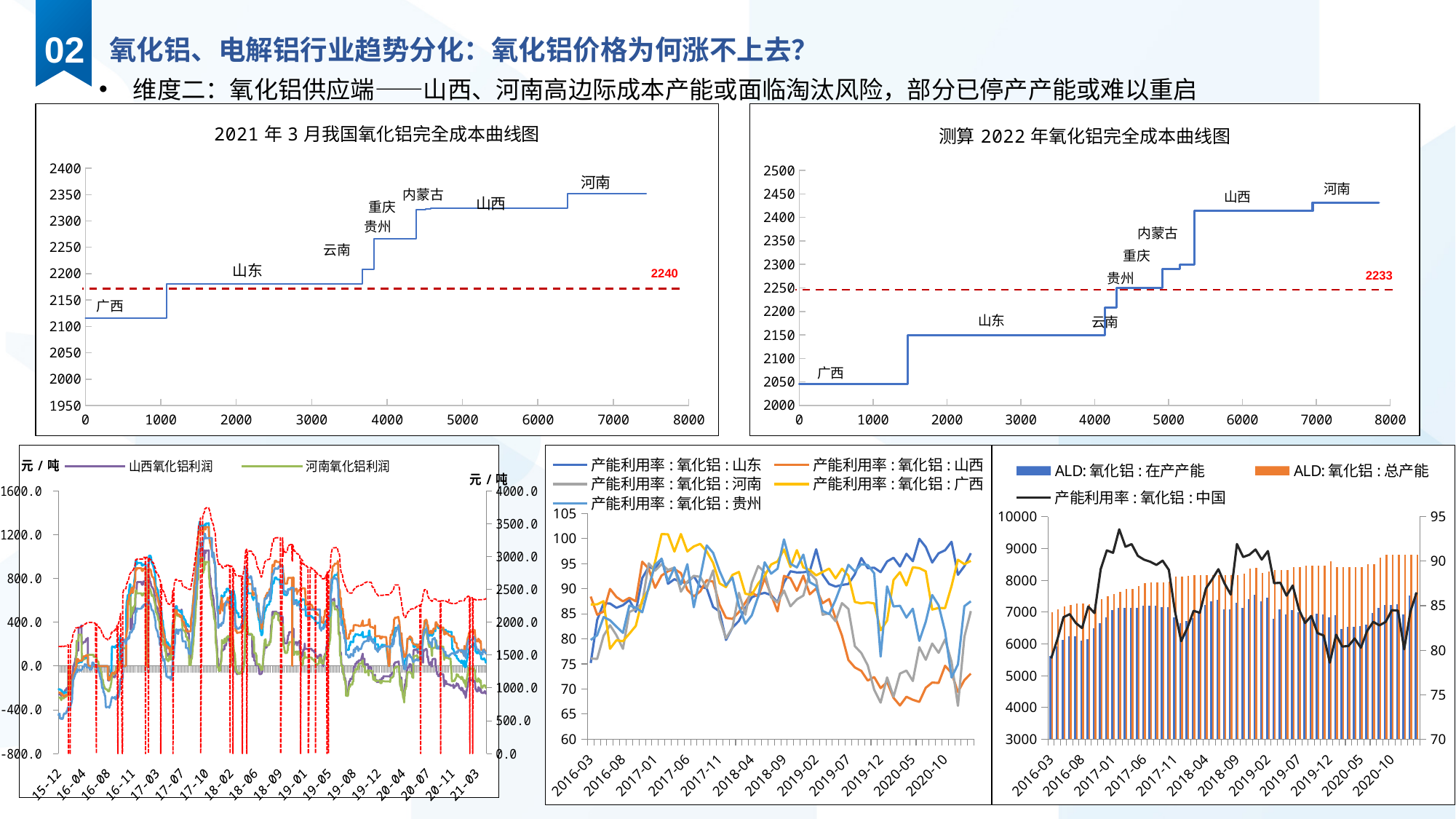
On the bottom-left chart, how many series does the legend list? 2 On the chart titled 测算2022年氧化铝完全成本曲线图, is the cost level for 山东 greater or less than 2200? less On the chart titled 测算2022年氧化铝完全成本曲线图, what value is printed on the red dashed horizontal line? 2233 On the chart titled 2021年3月我国氧化铝完全成本曲线图, is the cost level for 广西 greater or less than 2150? less On the chart titled 2021年3月我国氧化铝完全成本曲线图, which region has the highest cost step? 河南 On the bottom-middle chart showing 产能利用率 by province, how many series does the legend list? 5 On the chart titled 2021年3月我国氧化铝完全成本曲线图, what value is printed on the red dashed horizontal line? 2240 On the chart titled 测算2022年氧化铝完全成本曲线图, which region has the lowest cost step? 广西 On the chart titled 2021年3月我国氧化铝完全成本曲线图, how many regions are labelled along the cost curve? 8 On the chart titled 测算2022年氧化铝完全成本曲线图, is the cost level for 山西 greater or less than 2400? greater On the chart titled 2021年3月我国氧化铝完全成本曲线图, which region has the lowest cost step? 广西